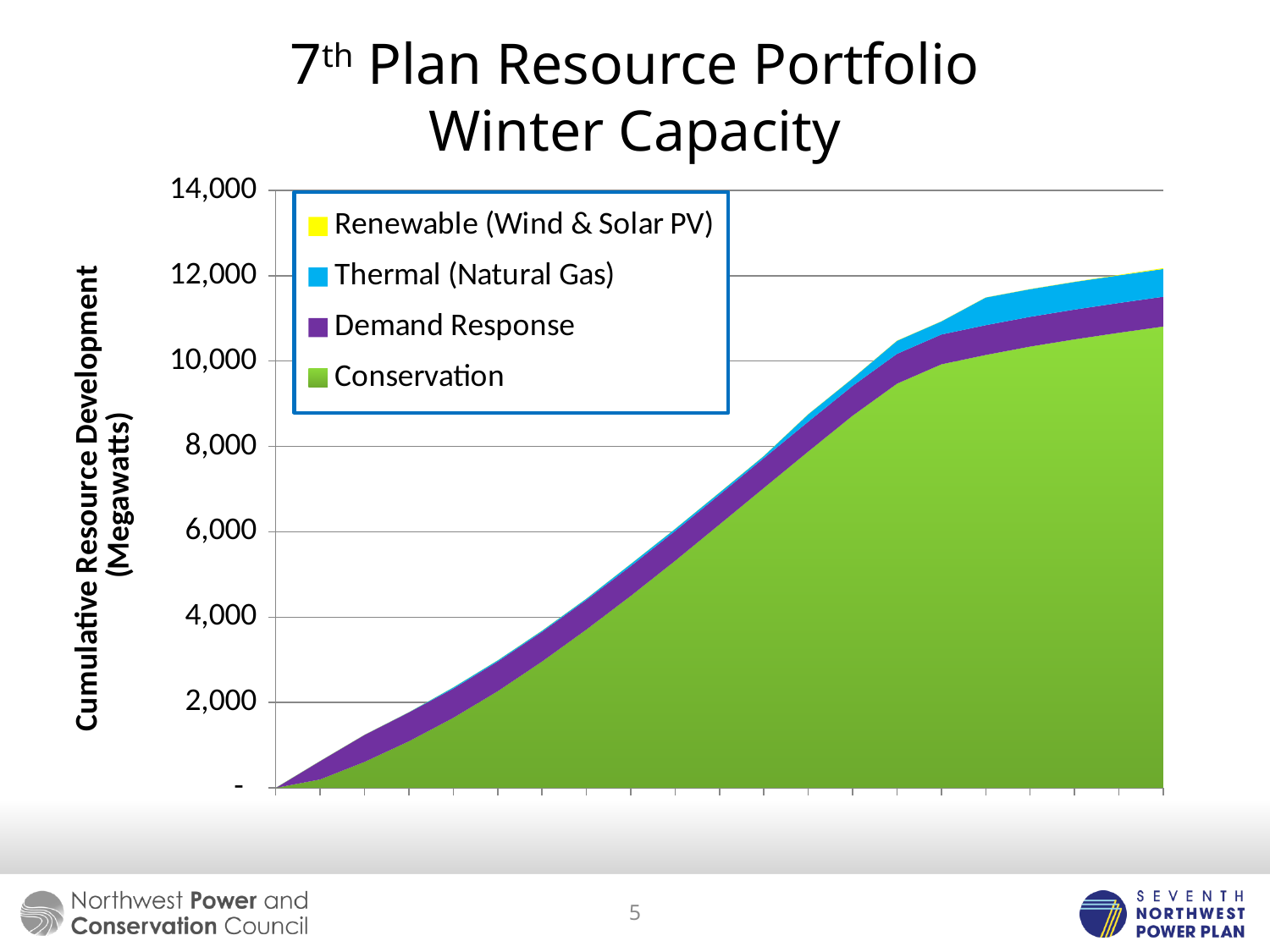
Is the total cumulative resource development at the right end of the chart greater or less than 10,000? greater What kind of chart is shown on the slide? Stacked area chart What is the label of the vertical axis? Cumulative Resource Development (Megawatts) Is the total cumulative resource development at the right end of the chart greater or less than 14,000? less Is the Conservation value at the right end of the chart greater or less than 10,000? greater Which series accounts for the smallest share of the cumulative resource development? Renewable (Wind & Solar PV) Do the cumulative values rise or fall from left to right along the x axis? Rise Which is larger at the right end of the chart, the Thermal (Natural Gas) band or the Conservation band? Conservation What is the highest value shown on the vertical axis? 14,000 What is the title of the chart? 7th Plan Resource Portfolio Winter Capacity How many series does the legend list? 4 Which series accounts for the largest share of the cumulative resource development? Conservation